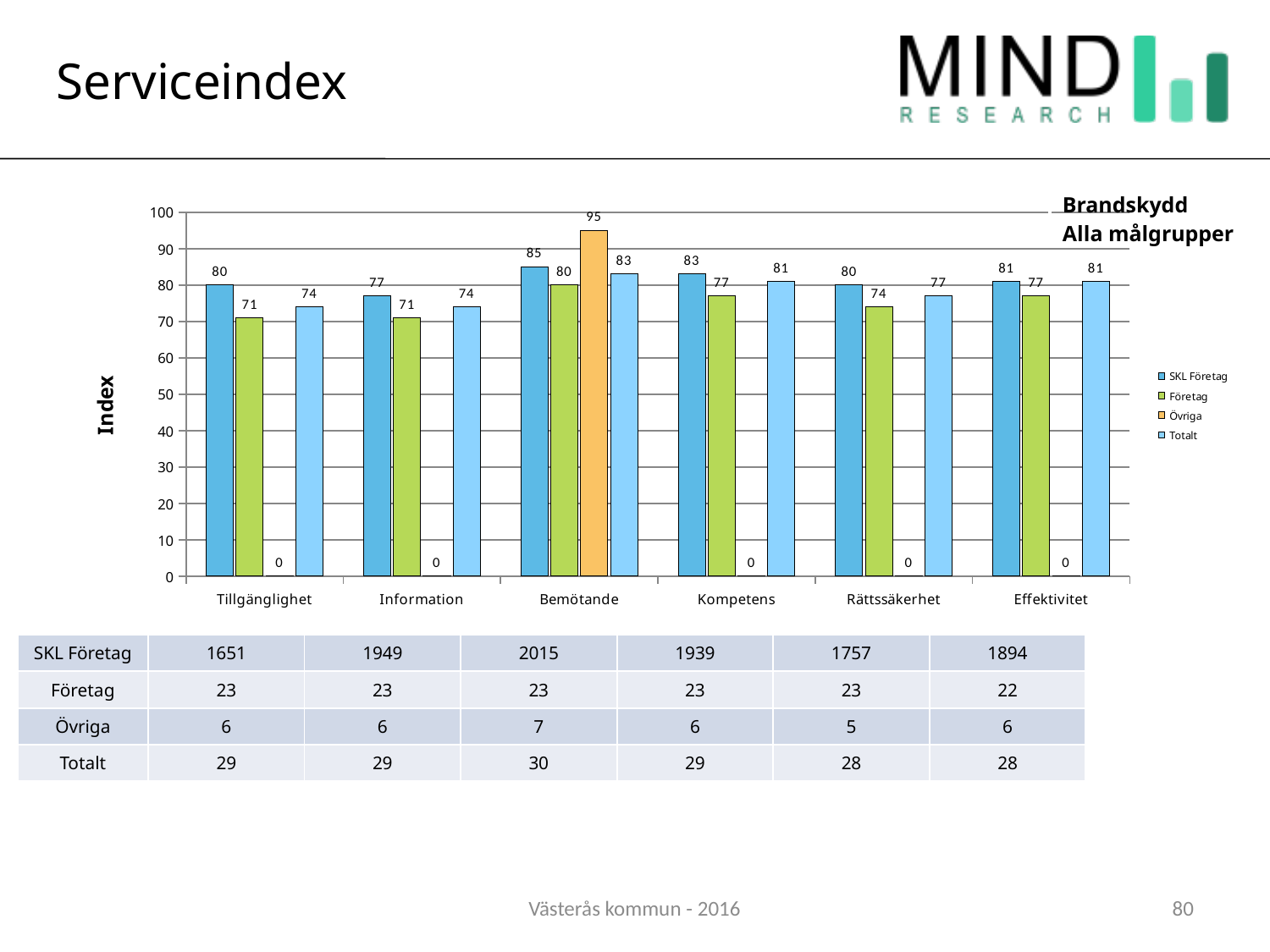
How many categories are shown on the x axis? 6 Which category has the lowest SKL Företag value? Information What is the SKL Företag value for Bemötande? 85 Which is larger for Effektivitet: the SKL Företag value or the Företag value? SKL Företag What is the Övriga value for Bemötande? 95 What is the difference between the SKL Företag and Företag values for Rättssäkerhet? 6 What is the label of the y axis? Index What is the Totalt value for Kompetens? 81 Which category has the highest Totalt value? Bemötande What is the Företag value for Tillgänglighet? 71 How many series does the legend list? 4 What kind of chart is shown on the slide? Bar chart